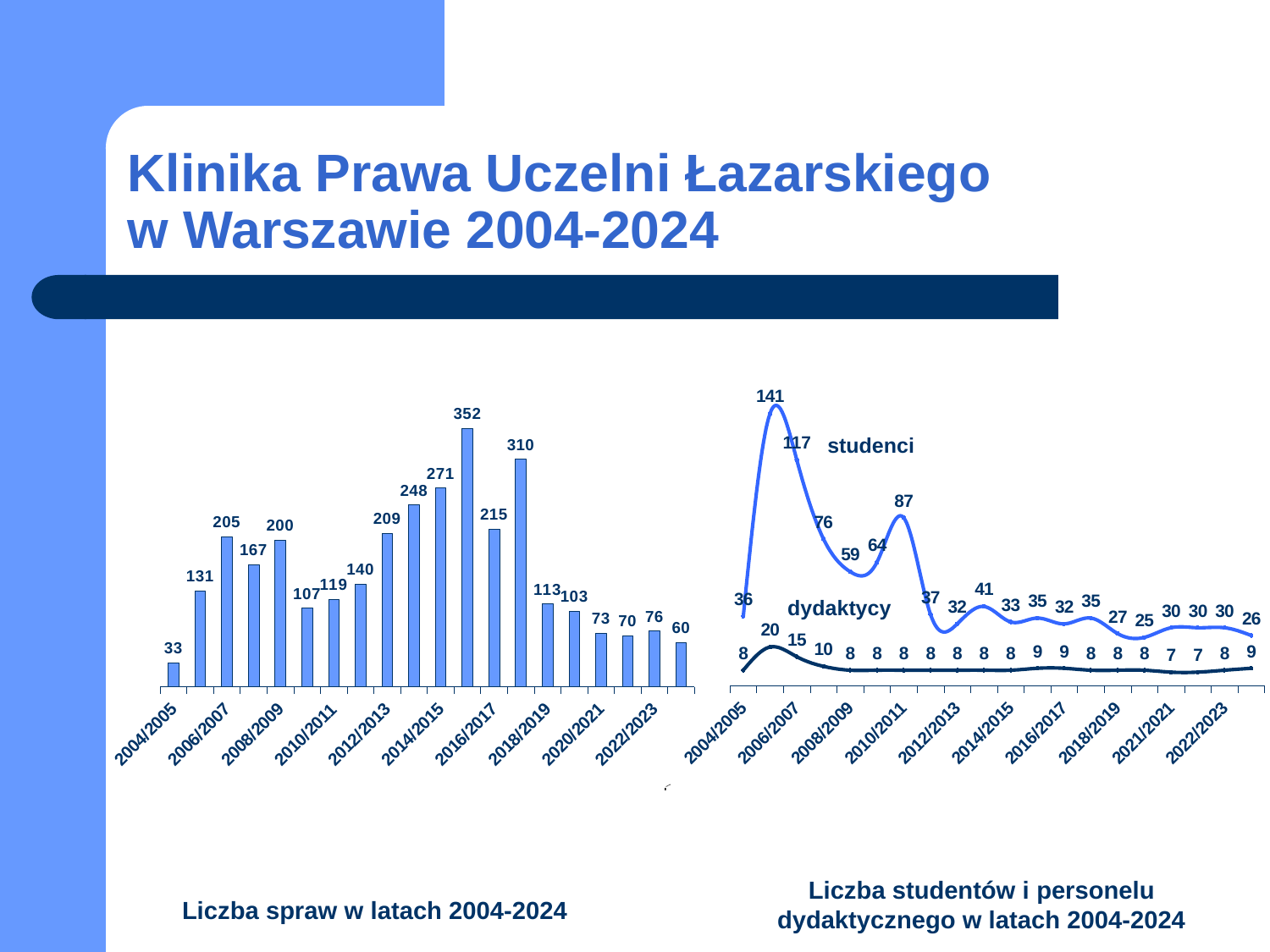
What are the names of the two series shown in the right chart 'Liczba studentów i personelu dydaktycznego w latach 2004-2024'? studenci and dydaktycy In the left chart 'Liczba spraw w latach 2004-2024', what is the lowest value shown? 33 In the right chart 'Liczba studentów i personelu dydaktycznego w latach 2004-2024', what is the highest value of the 'dydaktycy' series? 20 How many bars are plotted in the left chart 'Liczba spraw w latach 2004-2024'? 20 What kind of chart is the left chart, 'Liczba spraw w latach 2004-2024'? bar chart In the left chart 'Liczba spraw w latach 2004-2024', what is the value for 2004/2005? 33 In the left chart 'Liczba spraw w latach 2004-2024', what is the difference between the highest bar (352) and the second highest bar (310)? 42 In the left chart 'Liczba spraw w latach 2004-2024', which is larger: the value for 2006/2007 or the value for 2008/2009? 2006/2007 In the left chart 'Liczba spraw w latach 2004-2024', what is the highest value shown? 352 How many series are plotted in the right chart 'Liczba studentów i personelu dydaktycznego w latach 2004-2024'? 2 In the right chart 'Liczba studentów i personelu dydaktycznego w latach 2004-2024', what is the value of 'studenci' for 2004/2005? 36 In the right chart 'Liczba studentów i personelu dydaktycznego w latach 2004-2024', what is the highest value of the 'studenci' series? 141